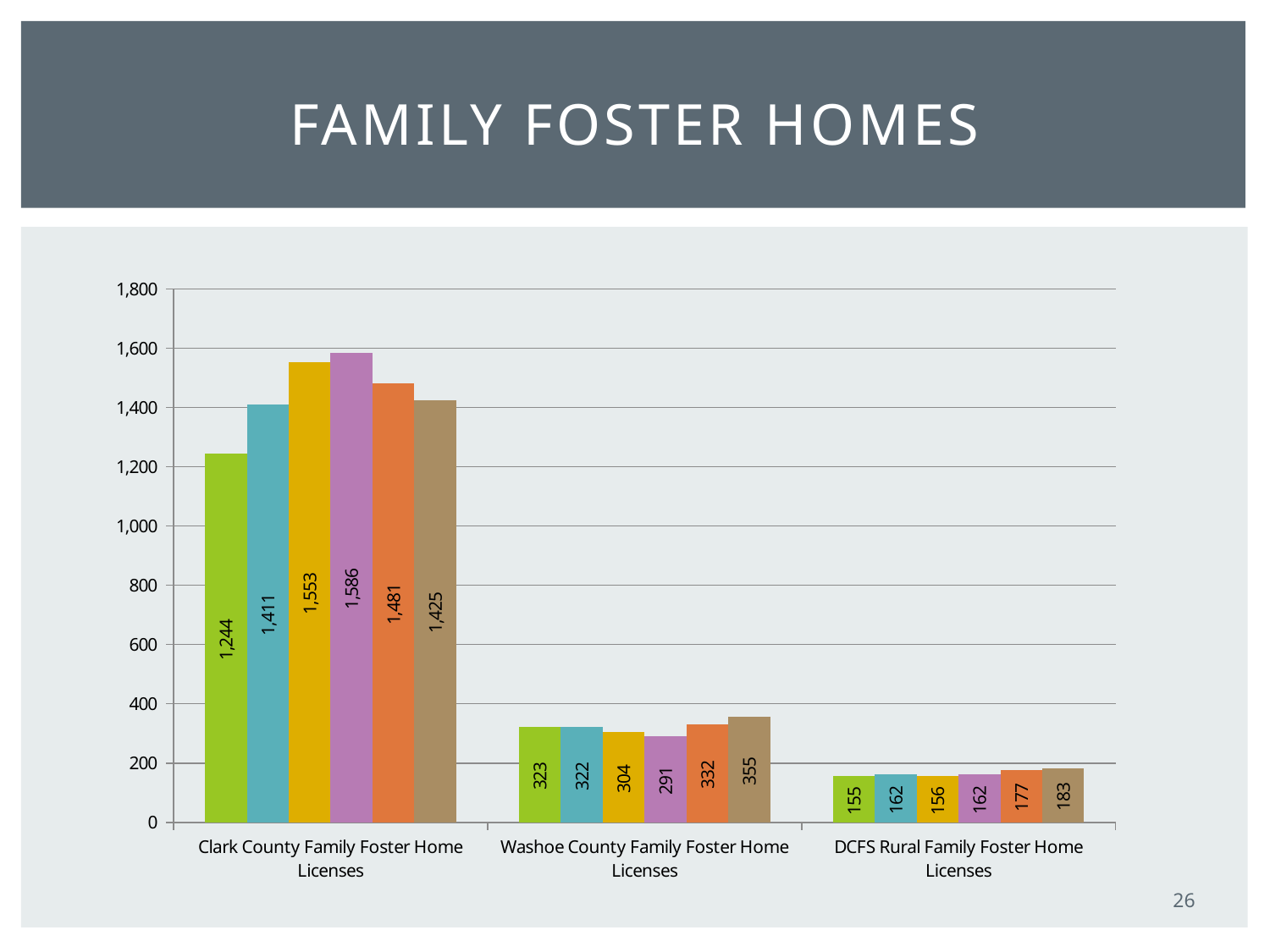
How many bars are shown for each category? 6 How many categories are shown on the x axis? 3 What is the value of the last (brown) bar for Washoe County Family Foster Home Licenses? 355 For DCFS Rural Family Foster Home Licenses, what is the difference between the brown bar and the green bar? 28 What is the value of the first (green) bar for Clark County Family Foster Home Licenses? 1,244 What is the value of the orange bar for DCFS Rural Family Foster Home Licenses? 177 What is the difference between the purple bar (1,586) and the green bar (1,244) for Clark County Family Foster Home Licenses? 342 For DCFS Rural Family Foster Home Licenses, which is larger: the orange bar or the brown bar? the brown bar (183) What type of chart is shown on the slide? bar chart What is the highest value shown for Clark County Family Foster Home Licenses? 1,586 What is the lowest value shown for Washoe County Family Foster Home Licenses? 291 Is the value of the green bar for Washoe County Family Foster Home Licenses greater or less than 400? less